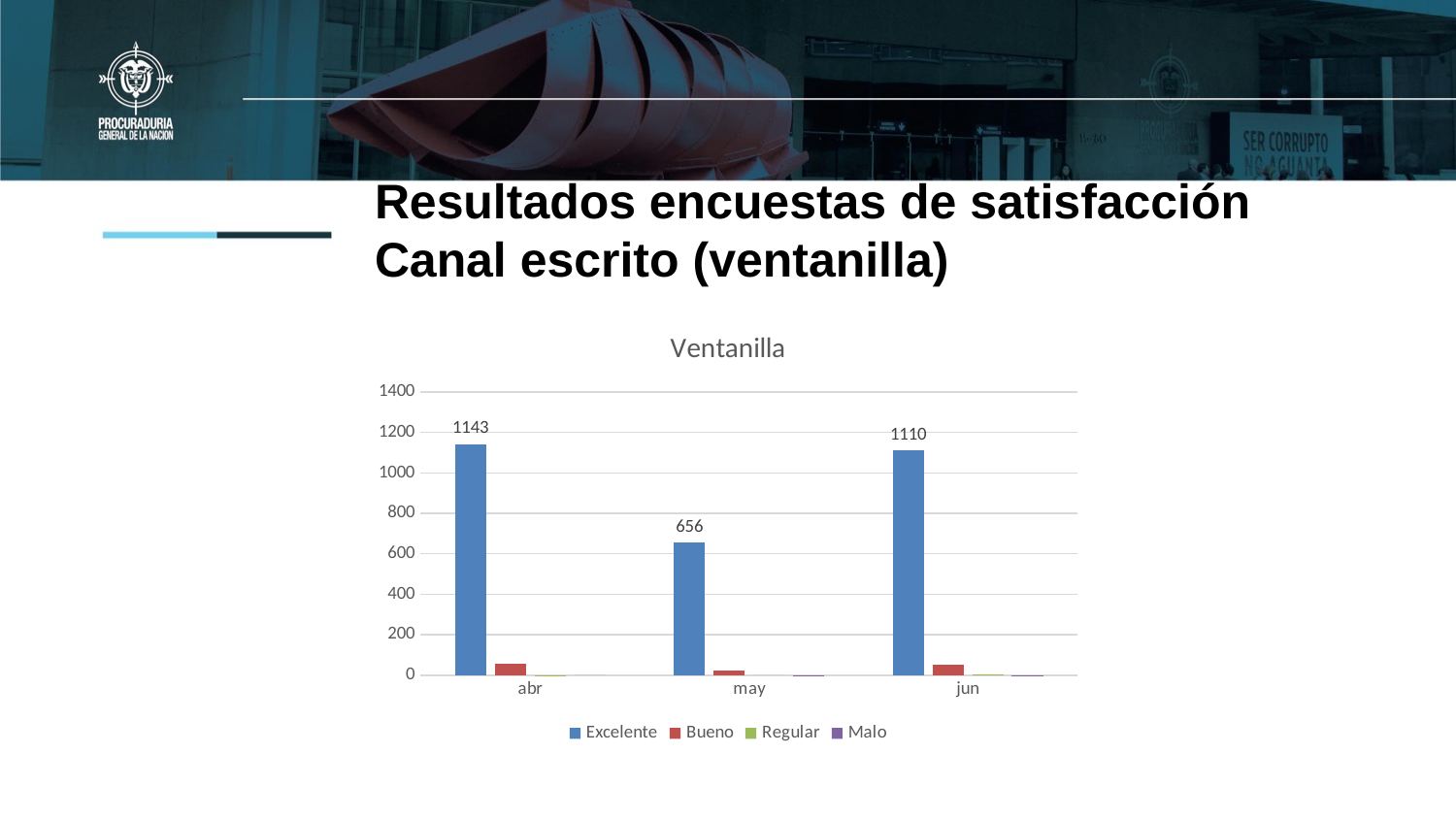
Which month has the highest Excelente value? abr What is the value for Excelente in may? 656 What kind of chart is shown? bar chart Is the Excelente value for abr or jun larger? abr How many months are shown on the x axis? 3 Which month has the lowest Excelente value? may What is the value for Excelente in jun? 1110 What is the difference between the Excelente values for abr and may? 487 What is the title of the chart? Ventanilla Is the value for Bueno in abr greater or less than 200? less What is the value for Excelente in abr? 1143 How many series does the legend list? 4